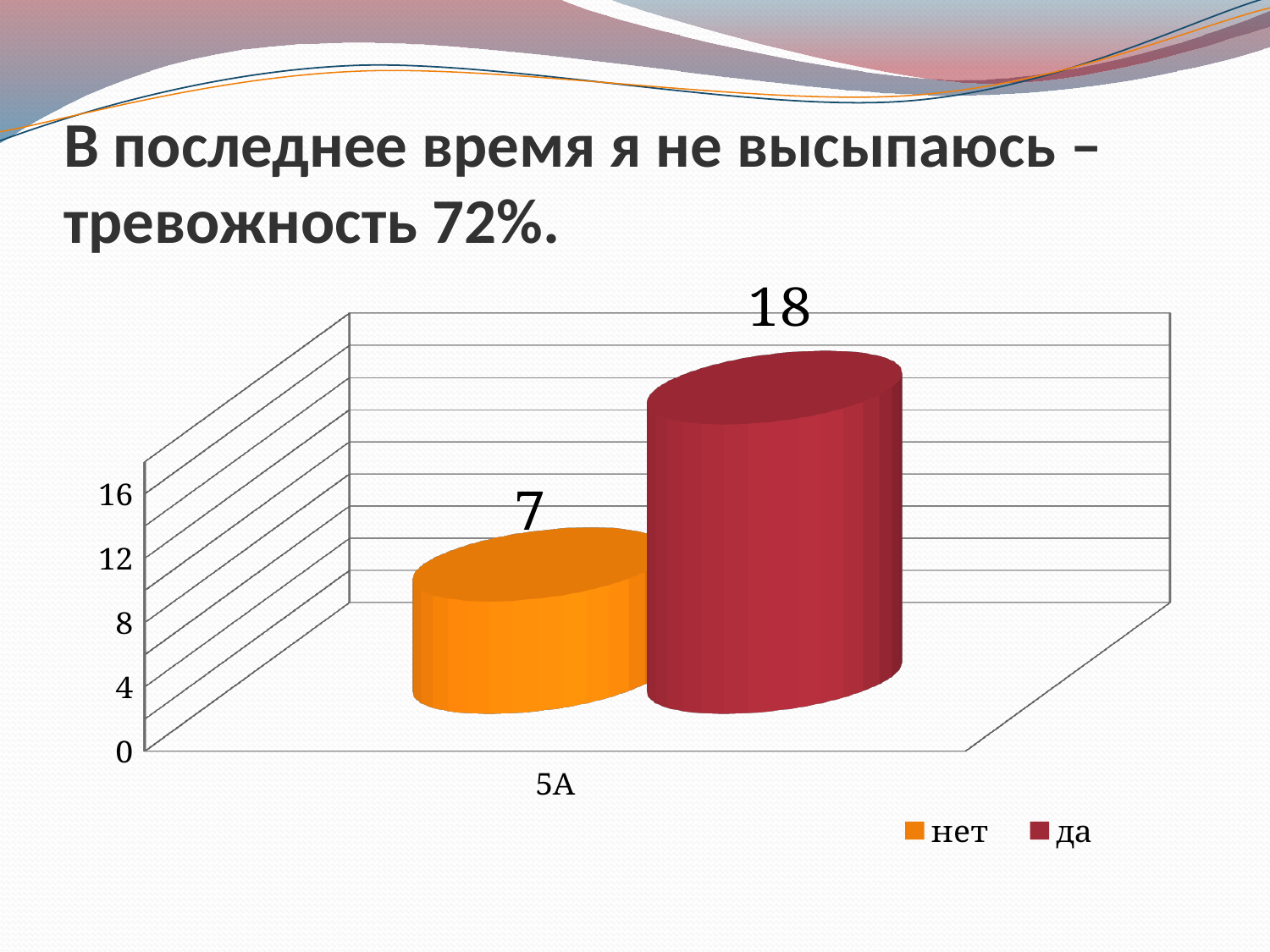
What is the value for "да" in the chart? 18 Which series has the higher value, "нет" or "да"? да Which series has the highest value in the chart? да What is the difference between the values for "да" and "нет"? 11 What colour is the bar for "да"? red Is the value for "да" greater or less than 16? greater Which series has the lowest value in the chart? нет Is the value for "нет" greater or less than 8? less What is the category label shown on the x axis? 5А What kind of chart is shown on the slide? bar chart What is the value for "нет" in the chart? 7 How many series does the legend list? 2